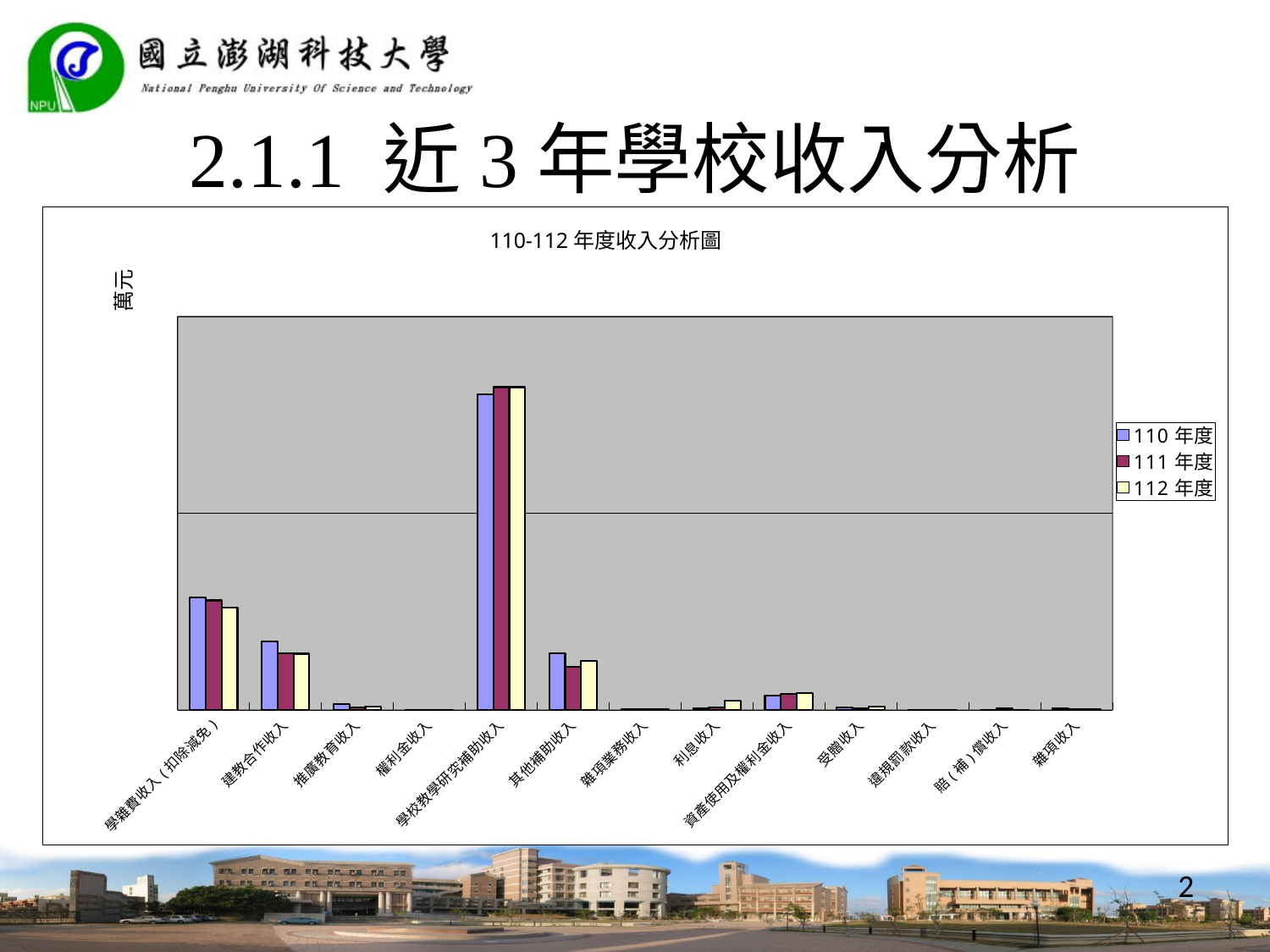
What is the title of the chart? 110-112 年度收入分析圖 Which is larger, the 110 年度 value for 學雜費收入(扣除減免) or the 110 年度 value for 建教合作收入? 學雜費收入(扣除減免) For 學雜費收入(扣除減免), which is larger, the 110 年度 value or the 112 年度 value? 110 年度 What unit label is shown on the y axis of the chart? 萬元 Which income category has the highest bars in the chart? 學校教學研究補助收入 For 利息收入, which is larger, the 110 年度 value or the 112 年度 value? 112 年度 Which category has the second-highest bars in the chart? 學雜費收入(扣除減免) How many series does the legend list? 3 Do the values for 學雜費收入(扣除減免) rise or fall from 110 年度 to 112 年度? Fall How many income categories are shown on the x axis? 13 What kind of chart is shown on the slide? Bar chart